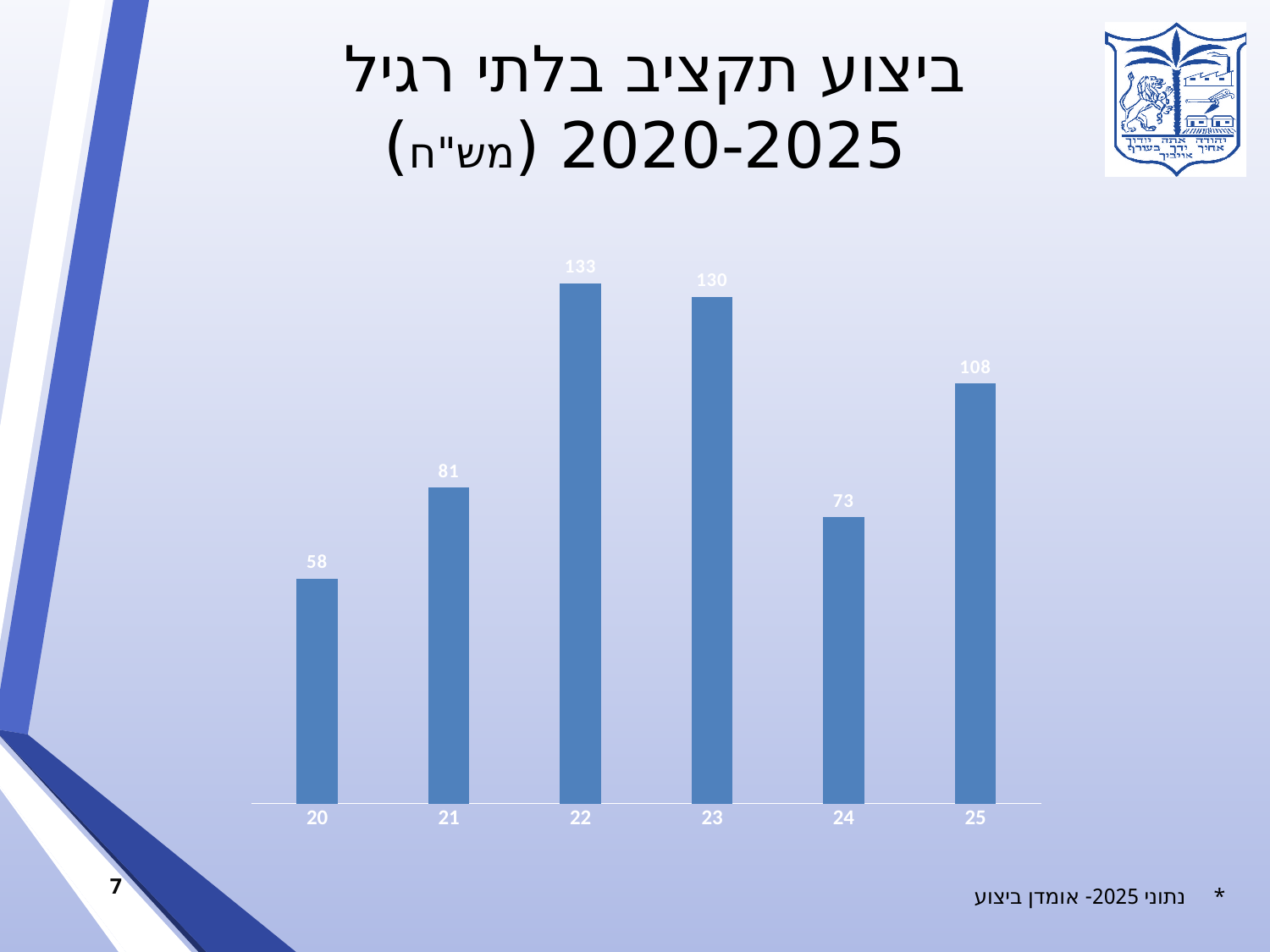
Which is larger, the value for 21 or the value for 24? 21 How many bars are shown in the chart? 6 Which category has the lowest value? 20 Do the values rise or fall from category 23 to category 24? fall Which category has the highest value? 22 What kind of chart is shown on the slide? bar chart What is the difference between the values for 25 and 24? 35 What is the value for category 23? 130 What is the value for category 20? 58 What is the value for category 22? 133 What is the difference between the values for 22 and 23? 3 What is the value for category 25? 108